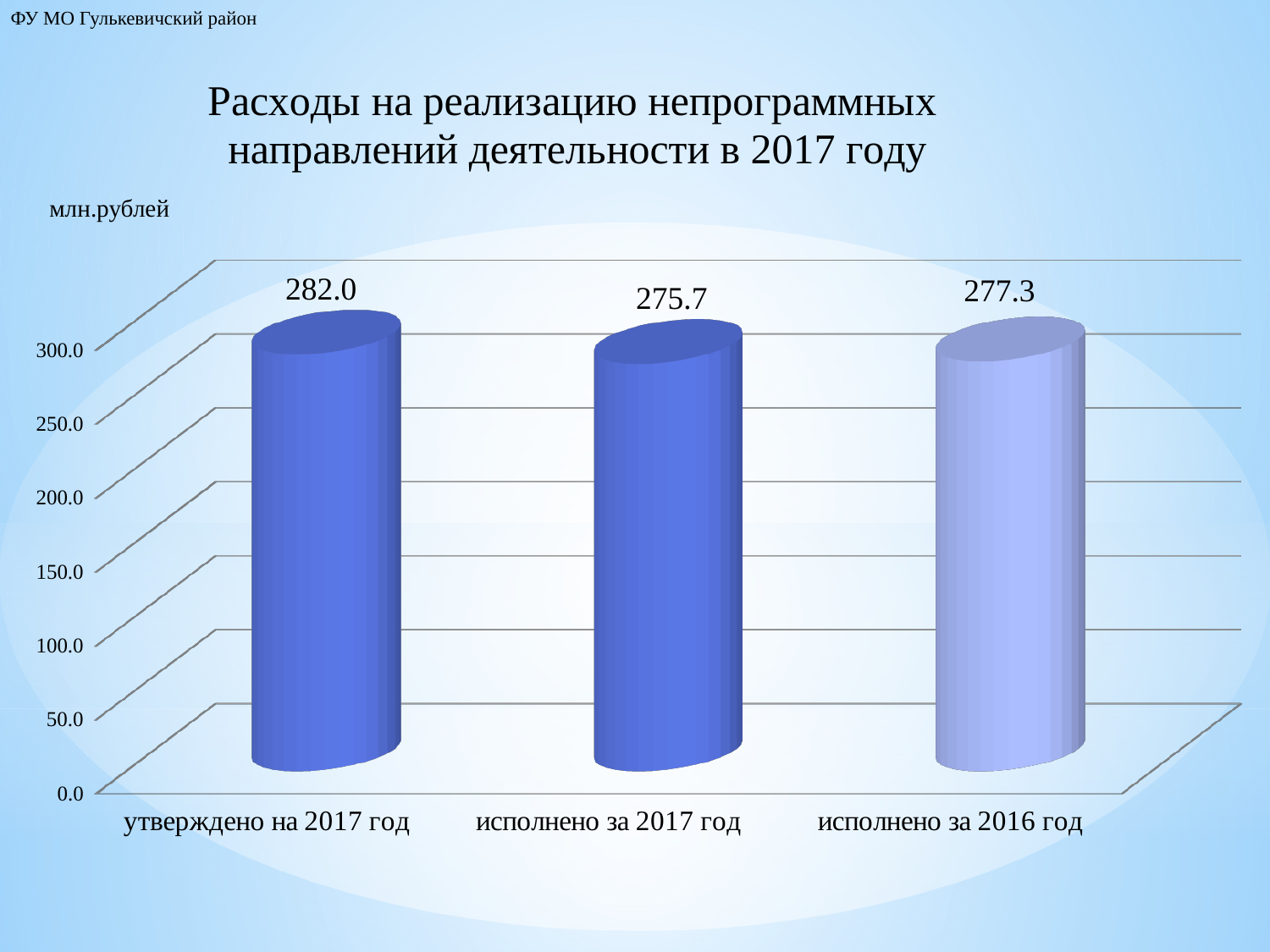
What is the value for «исполнено за 2016 год»? 277.3 Which category has the lowest value? исполнено за 2017 год How many categories are shown in the chart? 3 What is the value for «исполнено за 2017 год»? 275.7 What is the difference between «исполнено за 2016 год» and «исполнено за 2017 год»? 1.6 Is the value for «исполнено за 2017 год» greater or less than 250.0? greater What is the value for «утверждено на 2017 год»? 282.0 What kind of chart is shown on the slide? bar chart What is the difference between «утверждено на 2017 год» and «исполнено за 2017 год»? 6.3 Which is larger: «утверждено на 2017 год» or «исполнено за 2016 год»? утверждено на 2017 год Which category has the highest value? утверждено на 2017 год What unit of measurement is indicated for the chart values? млн.рублей